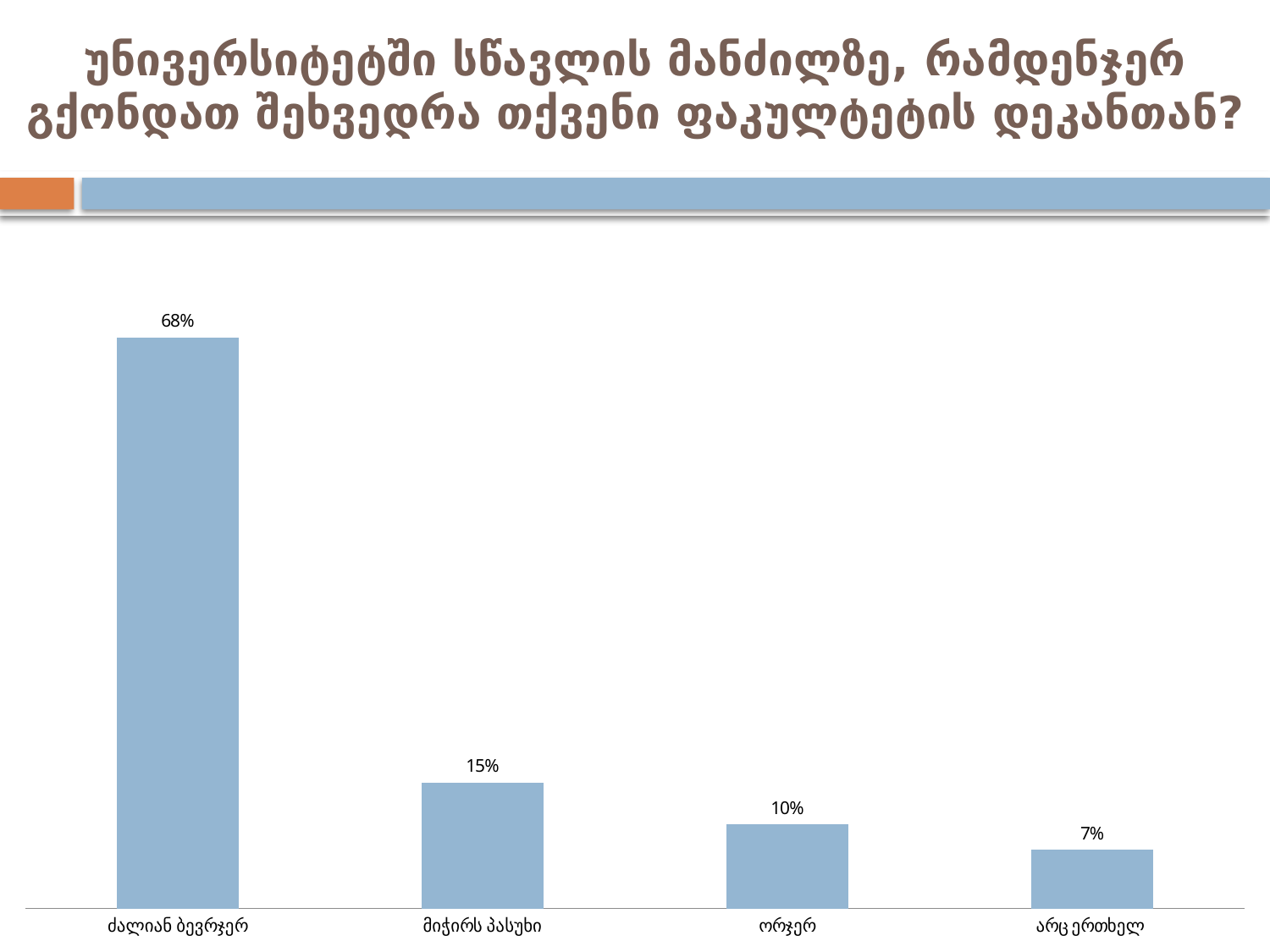
What kind of chart is shown on the slide? bar chart What is the value for ძალიან ბევრჯერ? 68% What is the value for არც ერთხელ? 7% Which is larger, the value for მიჭირს პასუხი or the value for ორჯერ? მიჭირს პასუხი What is the value for მიჭირს პასუხი? 15% How many categories are shown on the chart? 4 What is the value for ორჯერ? 10% Do the values rise or fall from left to right along the x axis? fall What is the difference between the values for ორჯერ and არც ერთხელ? 3% Which category has the lowest value? არც ერთხელ What is the difference between the values for ძალიან ბევრჯერ and მიჭირს პასუხი? 53% Which category has the highest value? ძალიან ბევრჯერ